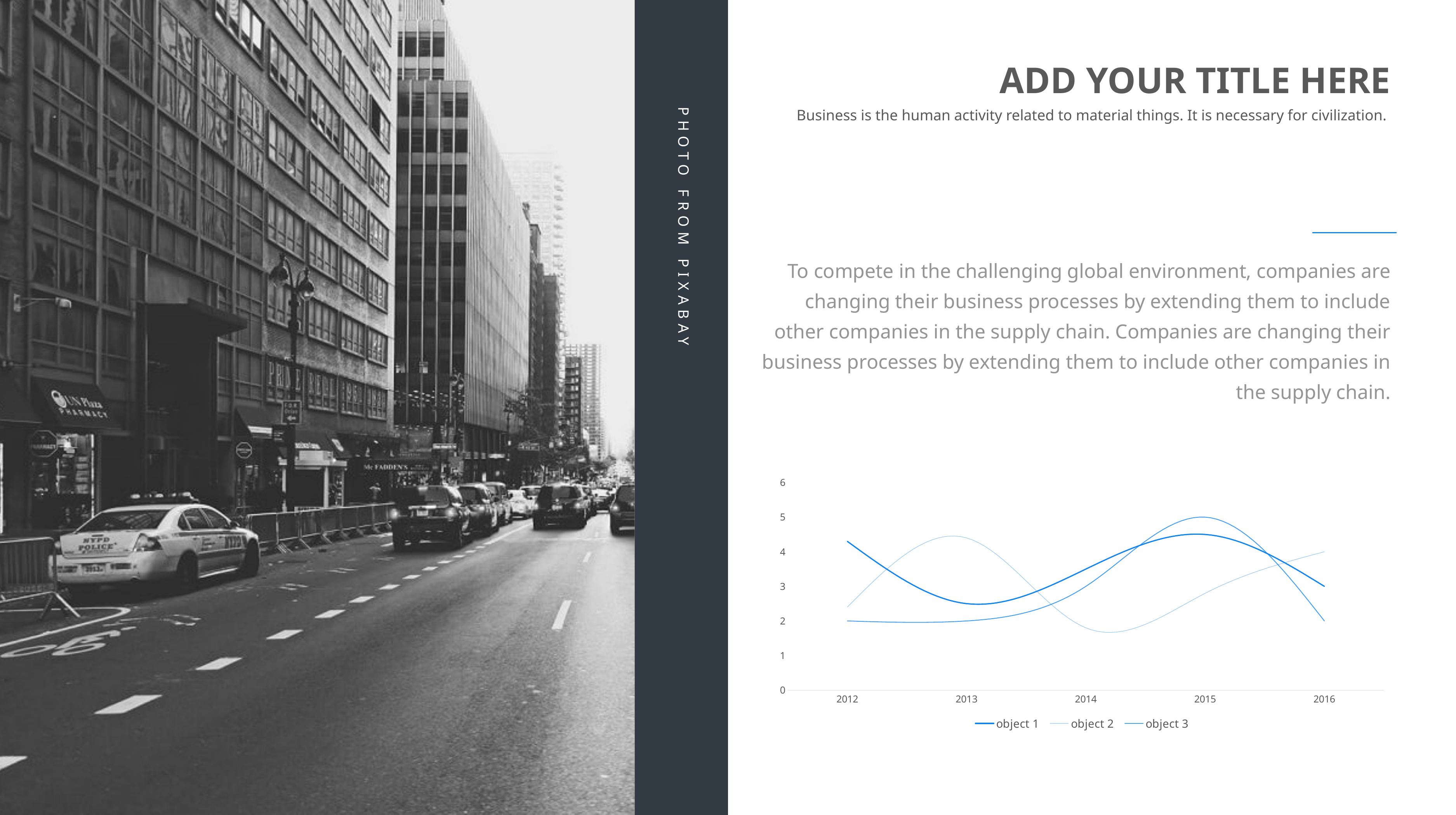
How many series does the chart legend list? 3 Is the value for object 2 in 2013 greater or less than 4? greater Is the value for object 3 in 2015 greater or less than 4? greater In 2013, which series has the higher value, object 1 or object 2? object 2 How many years are shown on the x axis of the chart? 5 Does the value for object 3 rise or fall from 2013 to 2015? rise In which year does object 1 reach its lowest value? 2013 In which year does object 3 reach its highest value? 2015 What are the names of the series in the chart legend? object 1, object 2, object 3 What kind of chart is shown on the slide? line chart Is the value for object 3 in 2016 greater or less than 3? less